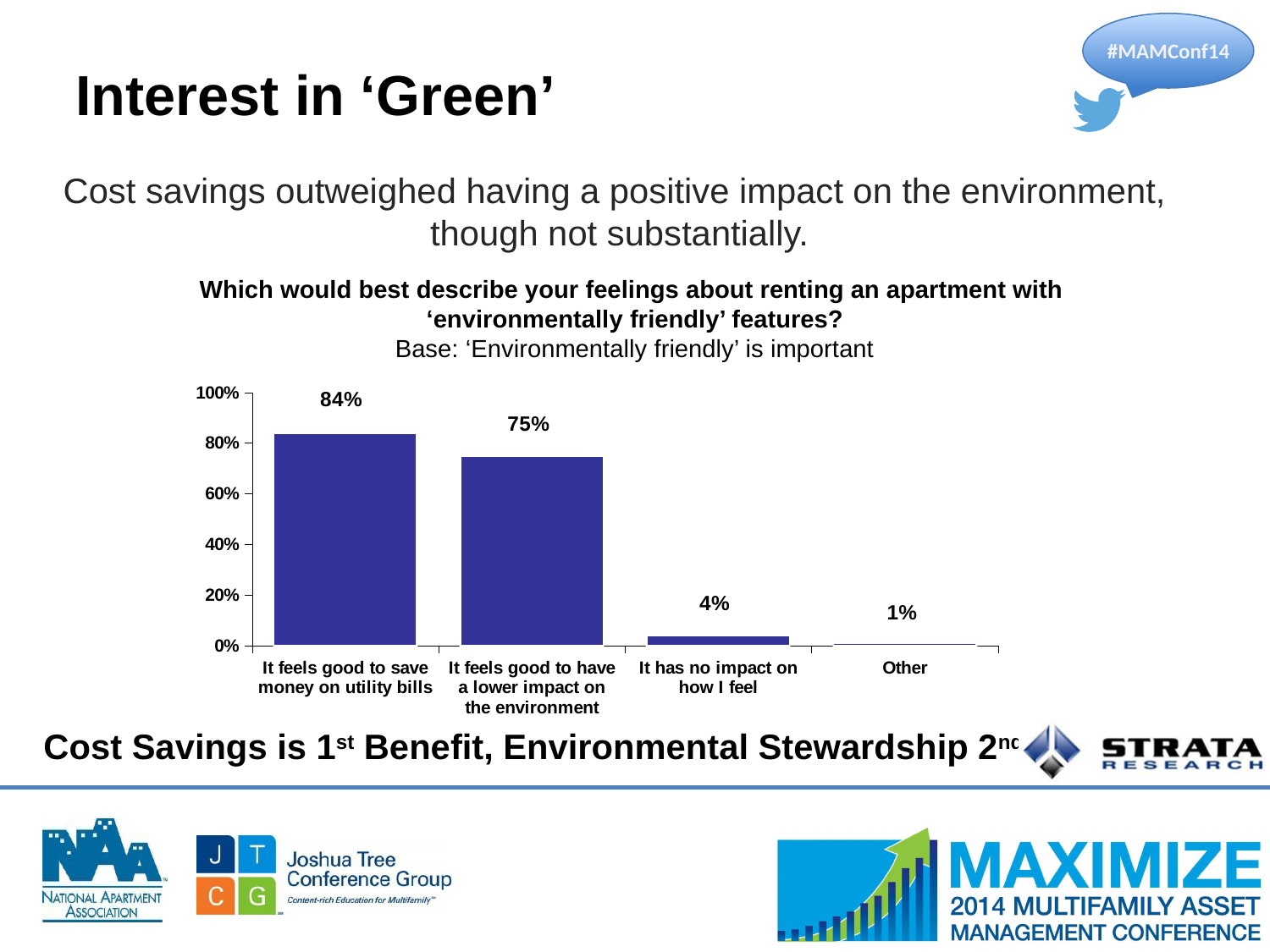
Is the value for 'It feels good to have a lower impact on the environment' greater or less than 60%? greater Which category has the lowest value? Other Which category has the highest value? It feels good to save money on utility bills What percentage of respondents said 'It feels good to have a lower impact on the environment'? 75% Which is larger: 'It has no impact on how I feel' or 'Other'? It has no impact on how I feel What is the value for 'It has no impact on how I feel'? 4% What percentage of respondents said 'It feels good to save money on utility bills'? 84% What is the difference between 'It feels good to save money on utility bills' and 'It feels good to have a lower impact on the environment'? 9 percentage points How many categories are shown on the chart? 4 What is the value for the 'Other' category? 1% What kind of chart is shown on the slide? Bar chart What is the base noted under the chart's question title? 'Environmentally friendly' is important